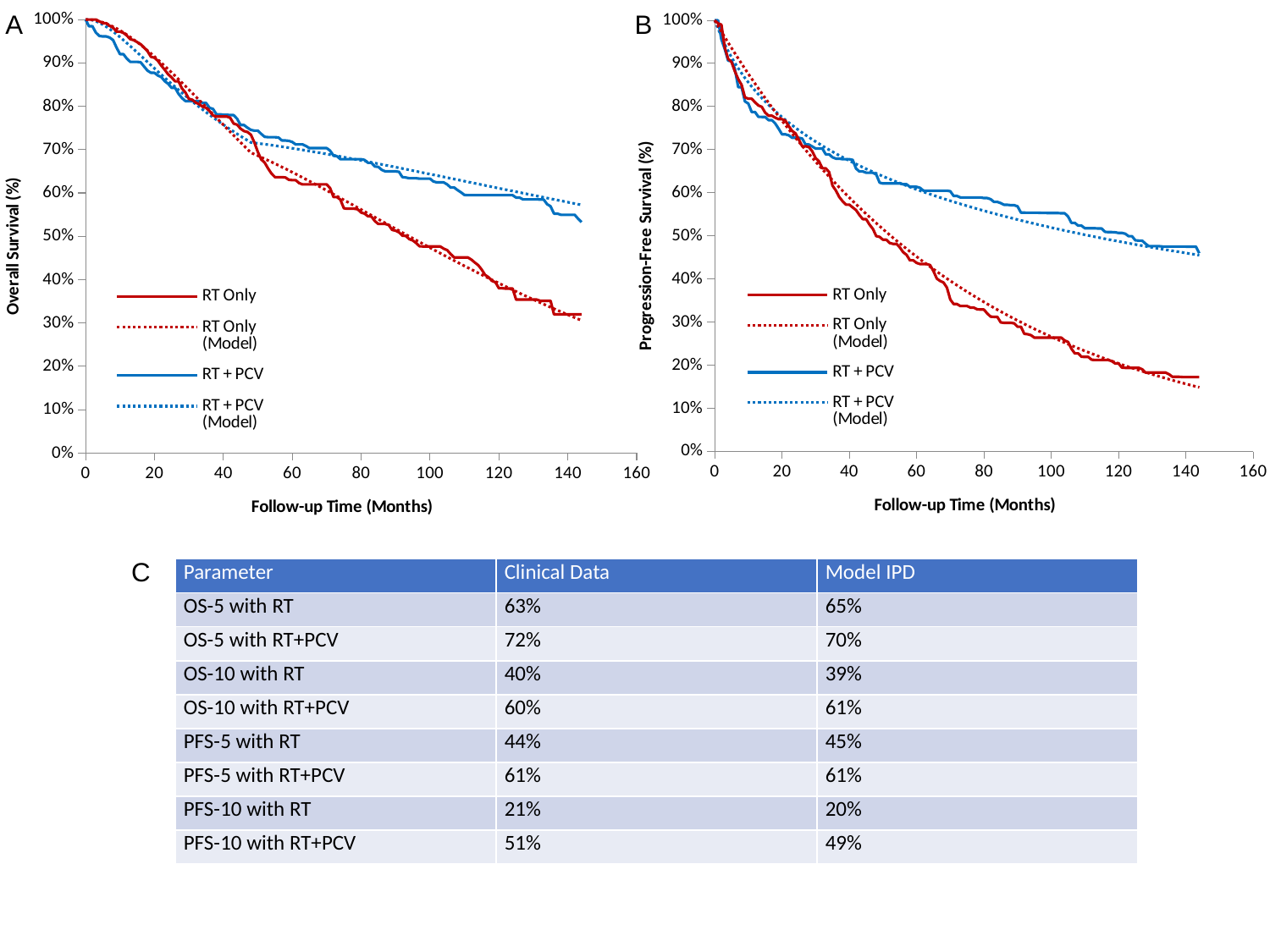
In chart A (Overall Survival), which series is higher at 140 months, RT Only or RT + PCV? RT + PCV In chart B (Progression-Free Survival), is the RT Only value at 140 months greater or less than 20%? less How many series does the legend of chart B (Progression-Free Survival) list? 4 In chart A (Overall Survival), do the survival curves rise or fall as follow-up time increases? fall What is the x-axis label of chart B (Progression-Free Survival)? Follow-up Time (Months) In chart A (Overall Survival), is the RT + PCV value at 140 months greater or less than 50%? greater In chart B (Progression-Free Survival), is the RT + PCV value at 140 months greater or less than 40%? greater What kind of chart is chart A (Overall Survival)? line chart In chart B (Progression-Free Survival), do the survival curves rise or fall as follow-up time increases? fall In chart B (Progression-Free Survival), which series is lower at 100 months, RT Only or RT + PCV? RT Only How many series does the legend of chart A (Overall Survival) list? 4